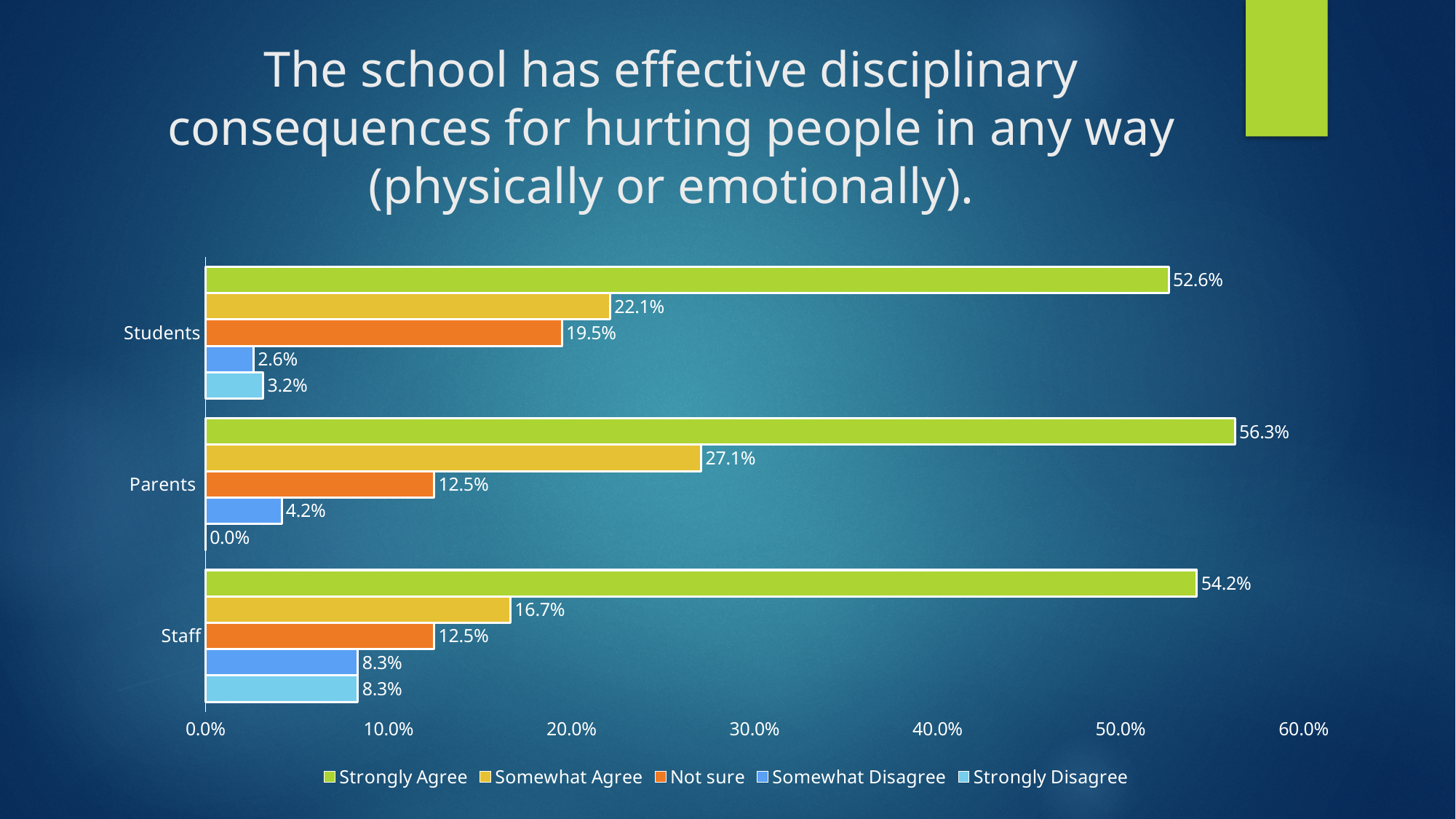
What is the difference between the Somewhat Agree percentages for Parents and Staff? 10.4% What kind of chart is shown on the slide? Bar chart How many groups are shown on the vertical axis? 3 Which group has the lowest Somewhat Agree percentage? Staff What percentage of Students responded Strongly Agree? 52.6% Which is larger: the Not sure percentage for Students or for Parents? Students Which group has the highest Strongly Agree percentage? Parents What percentage of Parents responded Somewhat Agree? 27.1% Which colour represents Strongly Agree in the legend? Green What percentage of Parents responded Strongly Disagree? 0.0% How many series does the legend list? 5 What percentage of Staff responded Not sure? 12.5%